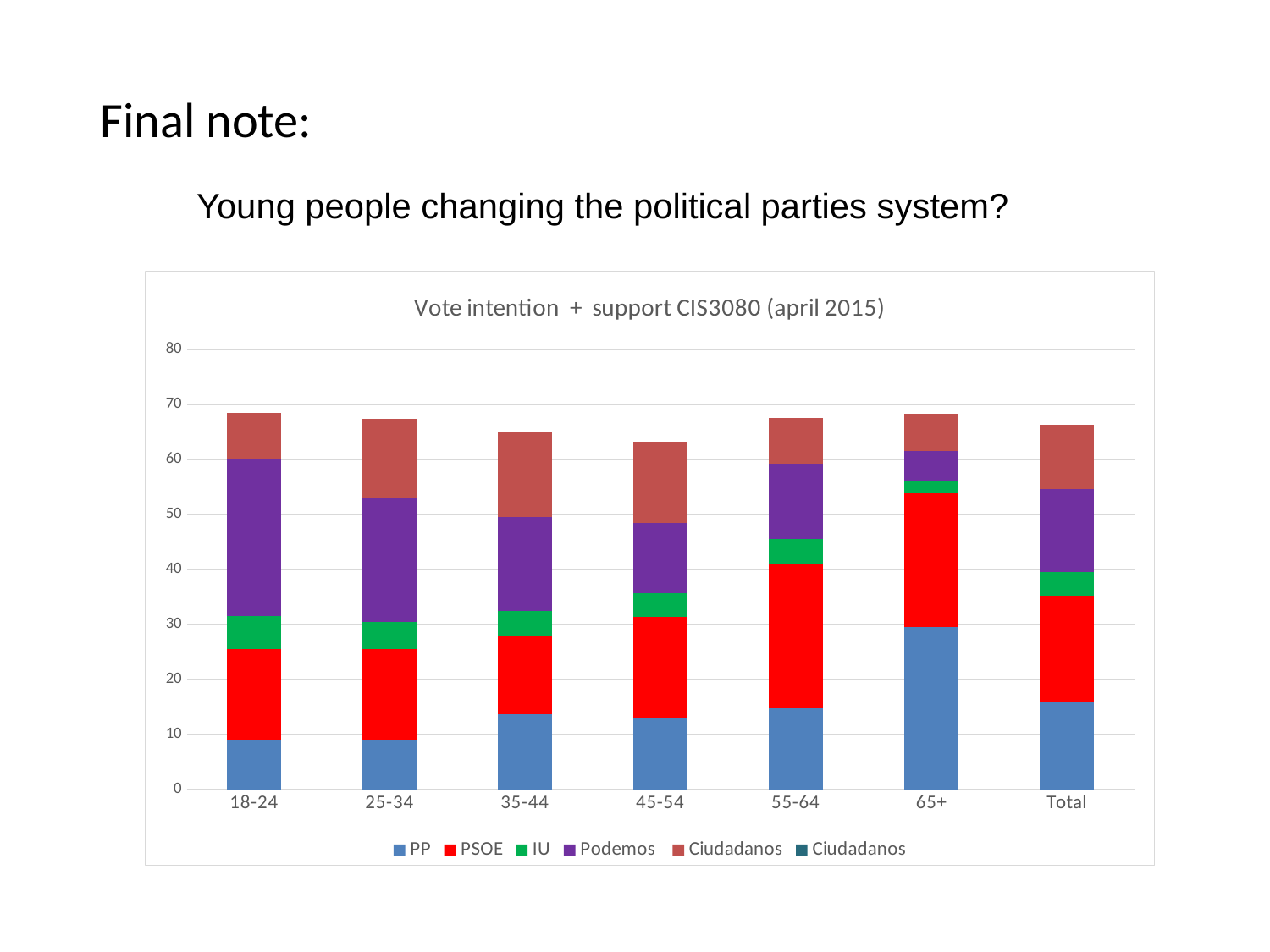
Which age group has the largest Podemos segment? 18-24 How many categories are shown on the x axis of the chart? 7 What type of chart is shown on the slide? Stacked bar chart Which is larger, the PP value for 65+ or the PP value for 18-24? 65+ Which age group has the smallest Podemos segment? 65+ Is the PP value for Total greater or less than 20? less Is the PP value for 65+ greater or less than 20? greater Is the total height of the 18-24 stacked bar greater or less than 60? greater How many series does the chart legend list? 6 What is the title of the chart? Vote intention + support CIS3080 (april 2015) Which age group has the highest PP value? 65+